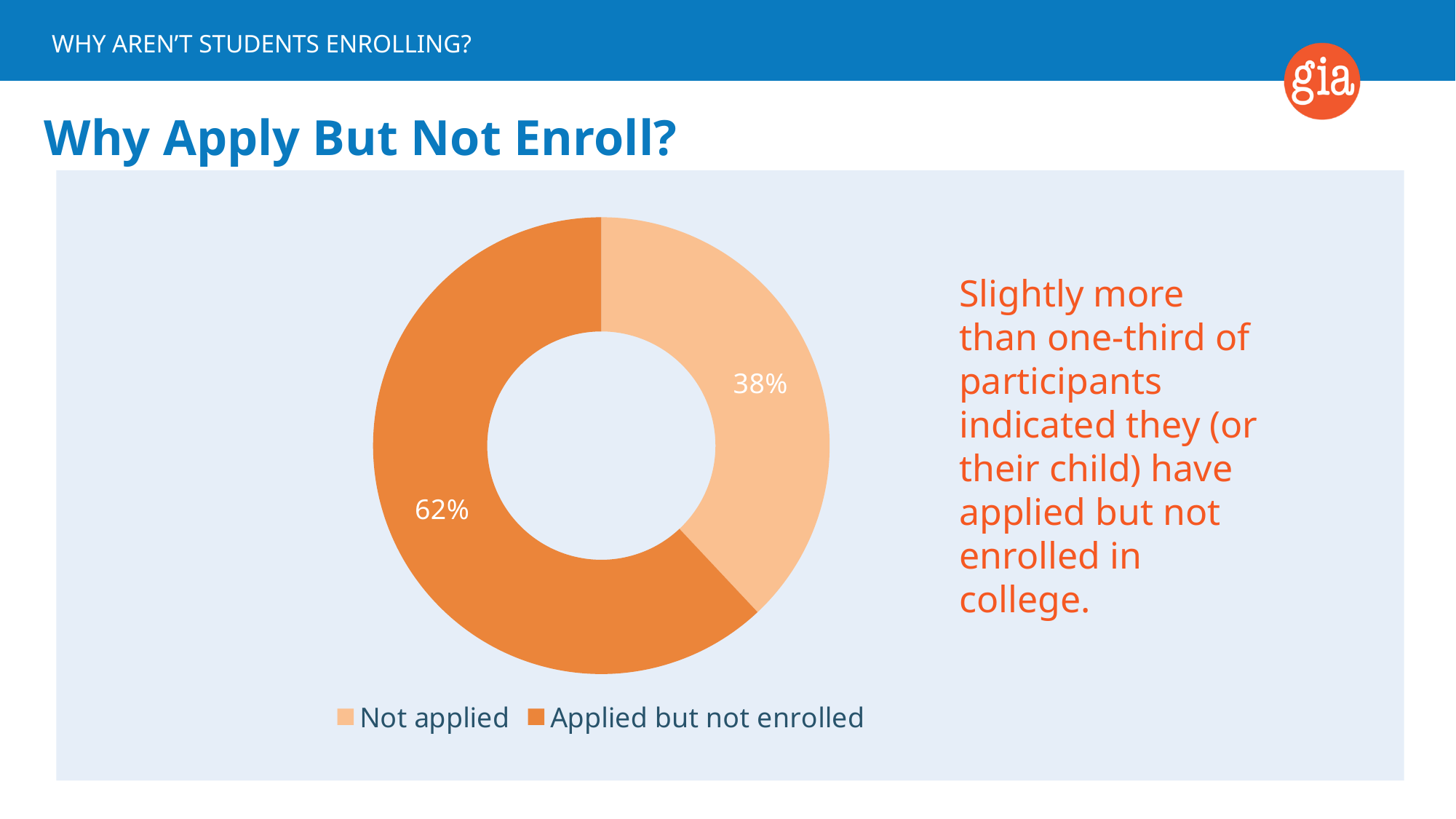
Which legend entry is shown in the darker orange colour? Applied but not enrolled Which category has the smallest share of the chart? Not applied What kind of chart is shown on the slide? Doughnut chart How many categories does the chart show? 2 What percentage of the doughnut chart is labelled "Not applied"? 38% How many entries does the legend list? 2 Which category has the largest share of the chart? Applied but not enrolled What share of the chart does the "Not applied" slice represent? 38% What is the title of the slide containing the chart? Why Apply But Not Enroll? What is the difference in percentage points between "Applied but not enrolled" and "Not applied"? 24 What percentage of the doughnut chart is labelled "Applied but not enrolled"? 62% Which is larger: the share for "Not applied" or the share for "Applied but not enrolled"? Applied but not enrolled